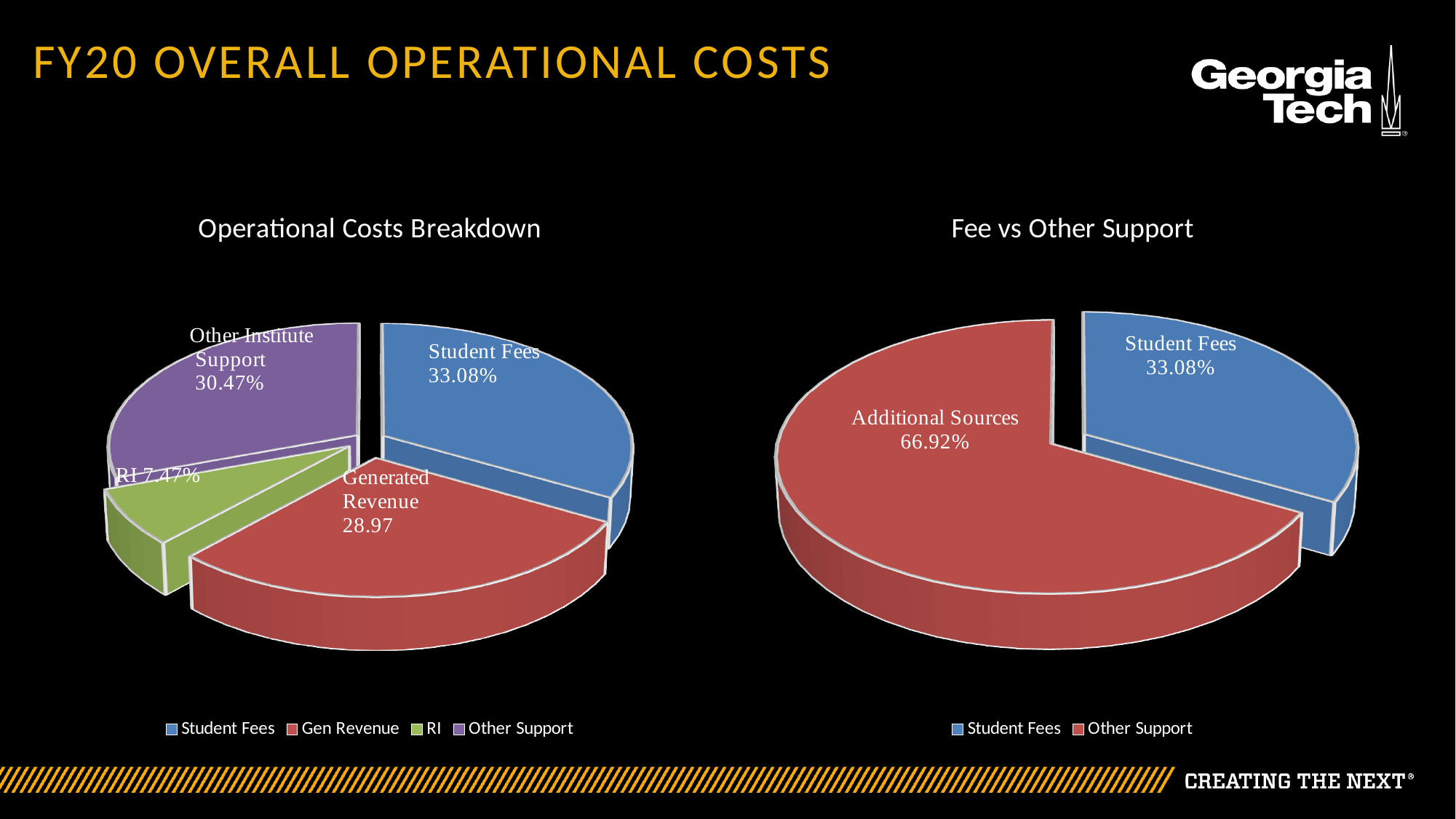
In the Operational Costs Breakdown chart, which slice is the smallest? RI In the Fee vs Other Support chart, what share is labelled for Additional Sources? 66.92% In the Operational Costs Breakdown chart, what share is labelled for Student Fees? 33.08% In the Fee vs Other Support chart, what is the difference between the Additional Sources share and the Student Fees share? 33.84% In the Operational Costs Breakdown chart, what share is labelled for RI? 7.47% In the Fee vs Other Support chart, which is larger, Student Fees or Additional Sources? Additional Sources What type of chart is the Fee vs Other Support chart? Pie chart In the Operational Costs Breakdown chart, what share is labelled for Other Institute Support? 30.47% In the Operational Costs Breakdown chart, which slice is the largest? Student Fees In the Operational Costs Breakdown chart, how many slices does the pie have? 4 In the Operational Costs Breakdown chart, what value is labelled for Generated Revenue? 28.97 In the Operational Costs Breakdown chart, what is the difference between the Student Fees share and the Other Institute Support share? 2.61%